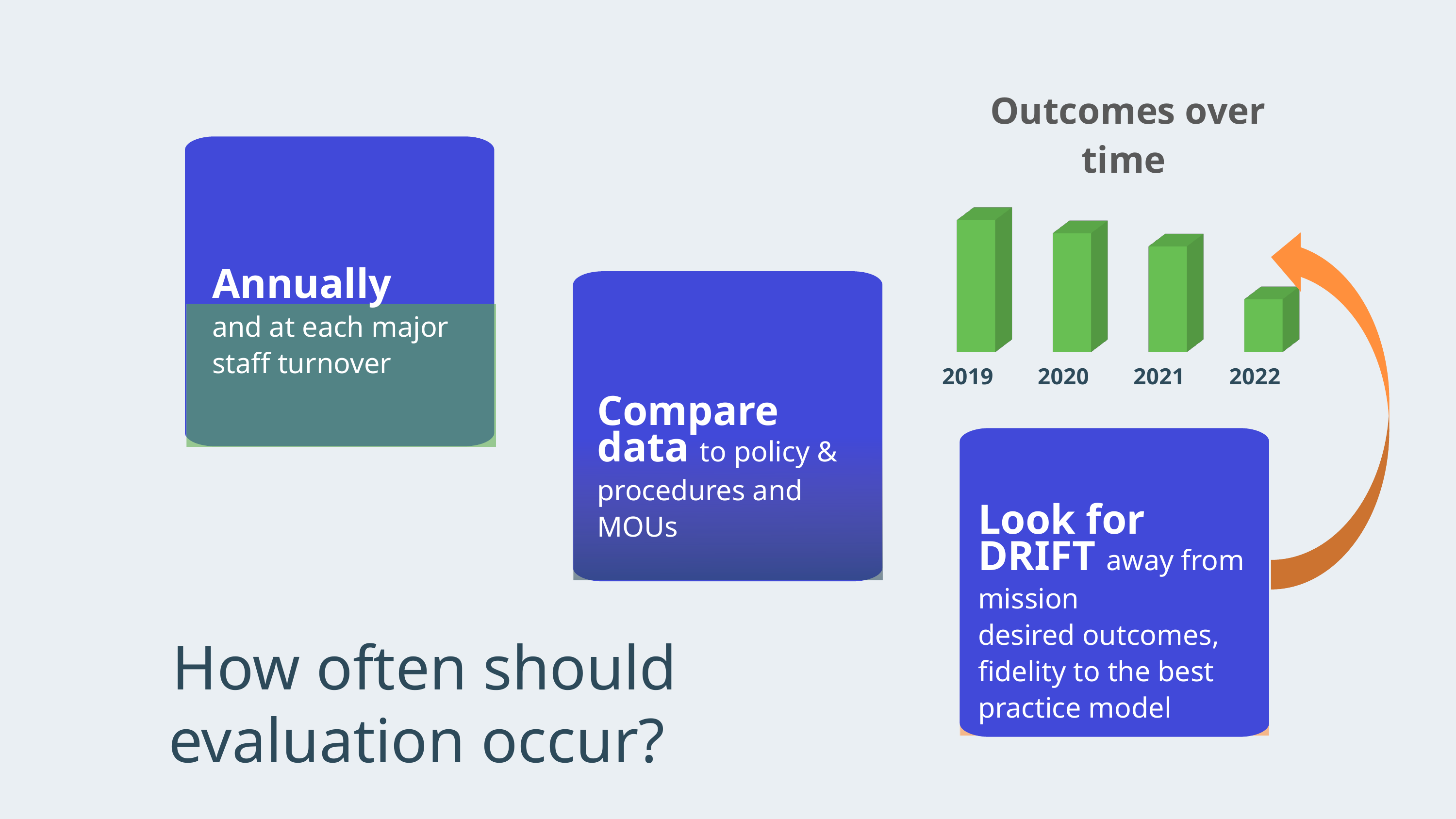
In the "Outcomes over time" chart, which bar is taller, 2019 or 2022? 2019 What is the first year shown on the x axis of the "Outcomes over time" chart? 2019 Which year has the tallest bar in the "Outcomes over time" chart? 2019 Do the bars in the "Outcomes over time" chart rise or fall from 2019 to 2022? fall Which year has the shortest bar in the "Outcomes over time" chart? 2022 What is the title of the chart on the slide? Outcomes over time In the "Outcomes over time" chart, is the bar for 2020 taller or shorter than the bar for 2021? taller In the "Outcomes over time" chart, is the bar for 2021 taller or shorter than the bar for 2022? taller What kind of chart is shown under the title "Outcomes over time"? bar chart How many bars does the "Outcomes over time" chart have? 4